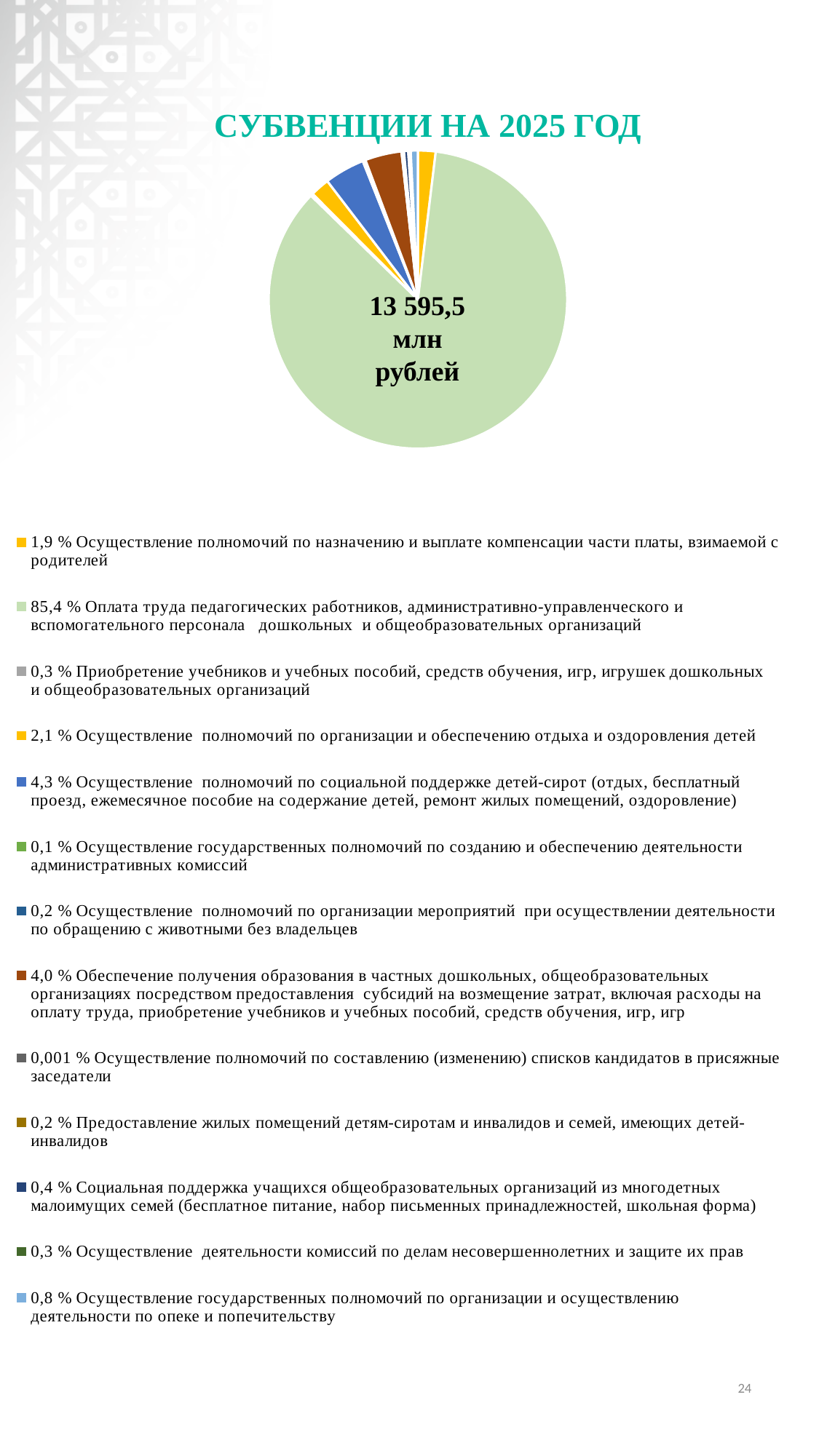
What percentage is shown for 'Осуществление государственных полномочий по организации и осуществлению деятельности по опеке и попечительству'? 0,8 % Which category has the smallest share of the pie? Осуществление полномочий по составлению (изменению) списков кандидатов в присяжные заседатели What share of the pie is 'Оплата труда педагогических работников, административно-управленческого и вспомогательного персонала дошкольных и общеобразовательных организаций'? 85,4 % What percentage is shown for 'Осуществление полномочий по организации и обеспечению отдыха и оздоровления детей'? 2,1 % What is the difference in percentage points between the share for 'Оплата труда педагогических работников' (85,4 %) and the share for 'Осуществление полномочий по социальной поддержке детей-сирот' (4,3 %)? 81,1 Which category has the largest share of the pie? Оплата труда педагогических работников, административно-управленческого и вспомогательного персонала дошкольных и общеобразовательных организаций How many categories does the legend of the pie chart list? 13 What share of the pie is 'Осуществление полномочий по социальной поддержке детей-сирот'? 4,3 % What total amount is printed in the centre of the pie chart? 13 595,5 млн рублей What kind of chart is shown on the slide? pie chart What is the title of the chart? СУБВЕНЦИИ НА 2025 ГОД Which is larger: the share for 'Осуществление полномочий по социальной поддержке детей-сирот' or the share for 'Обеспечение получения образования в частных дошкольных, общеобразовательных организациях'? Осуществление полномочий по социальной поддержке детей-сирот